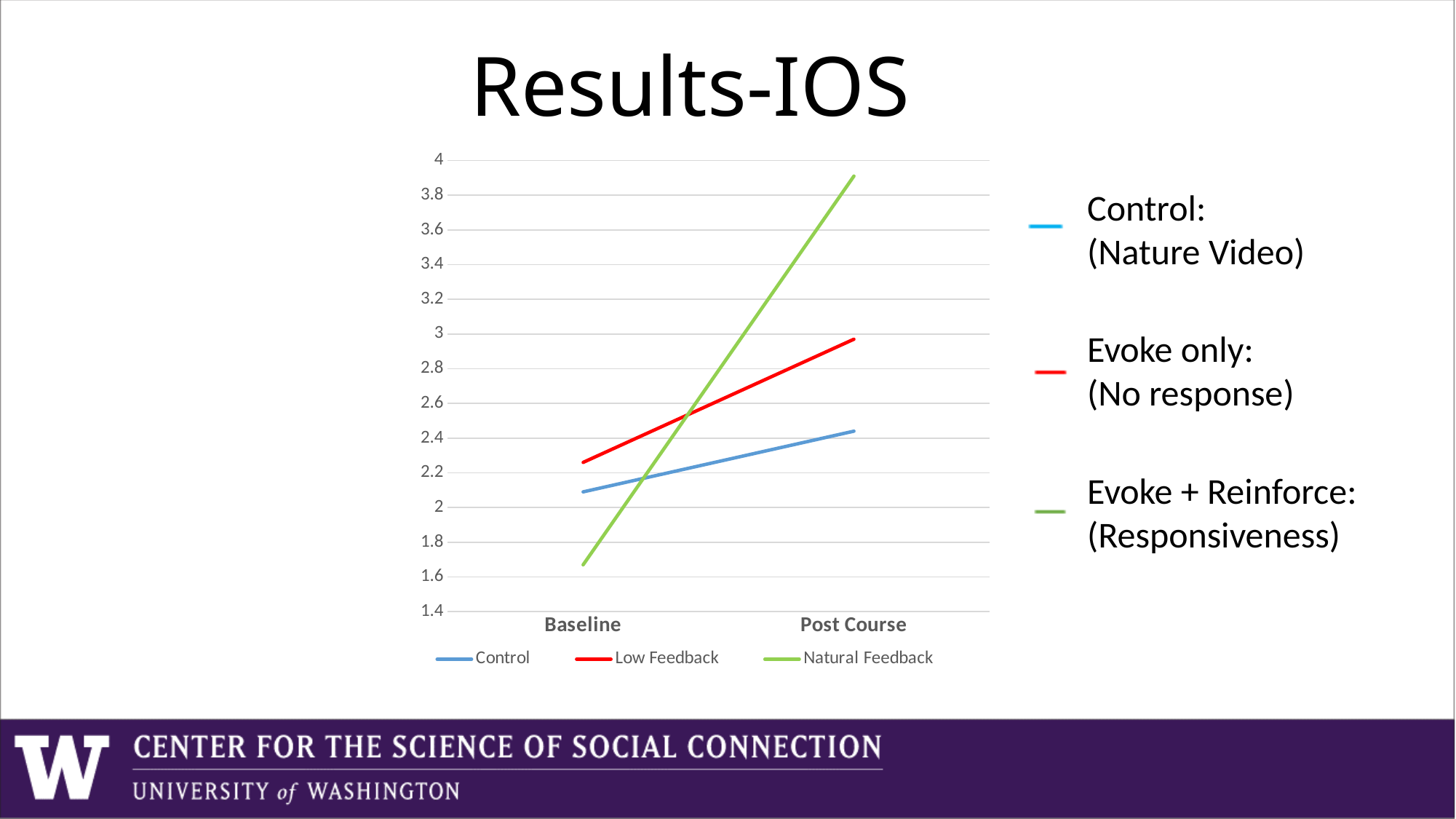
At Baseline, which is larger: the Control value or the Low Feedback value? Low Feedback What kind of chart is shown on the slide? line chart What is the title of the slide containing the chart? Results-IOS Which series has the lowest value at Baseline? Natural Feedback Is the Control value at Baseline greater or less than 2.2? less How many categories are shown on the x axis of the chart? 2 How many series does the chart legend list? 3 Is the Low Feedback value at Post Course greater or less than 2.8? greater Which series has the highest value at Post Course? Natural Feedback Is the Natural Feedback value at Baseline greater or less than 1.8? less Does the Control series rise or fall from Baseline to Post Course? rise